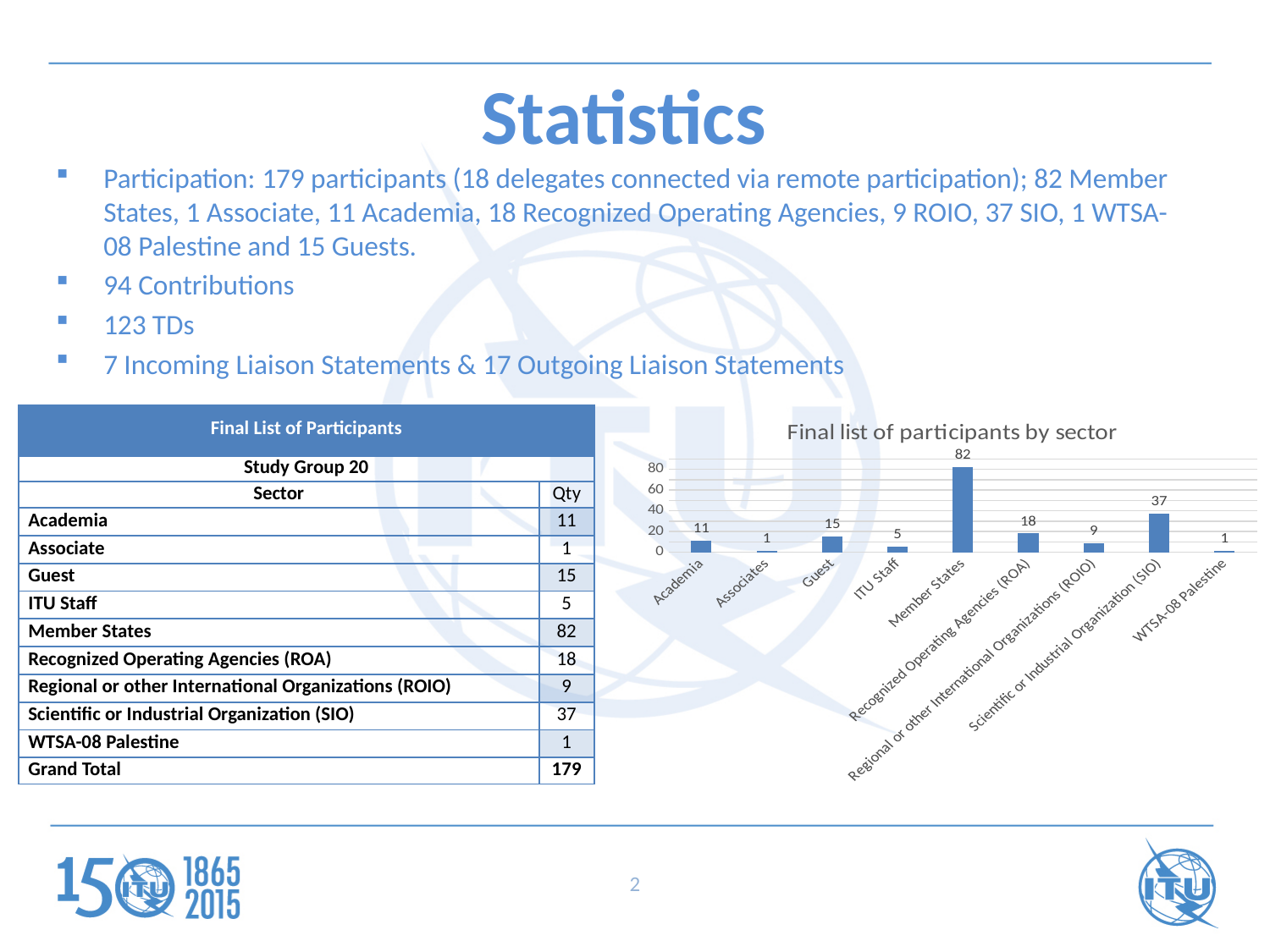
What is the value for ITU Staff in the chart? 5 Is the value for Scientific or Industrial Organization (SIO) greater or less than 20? greater What is the value for Guest in the chart? 15 Which is larger, the value for Guest or the value for Academia? Guest What is the difference between the values for Recognized Operating Agencies (ROA) and Academia? 7 What is the value for Scientific or Industrial Organization (SIO) in the chart? 37 What kind of chart is shown on the slide? Bar chart How many categories are shown on the x axis of the chart? 9 What is the difference between the values for Member States and Scientific or Industrial Organization (SIO)? 45 What is the title of the chart? Final list of participants by sector Which category has the highest value in the chart? Member States What is the value for Member States in the chart? 82